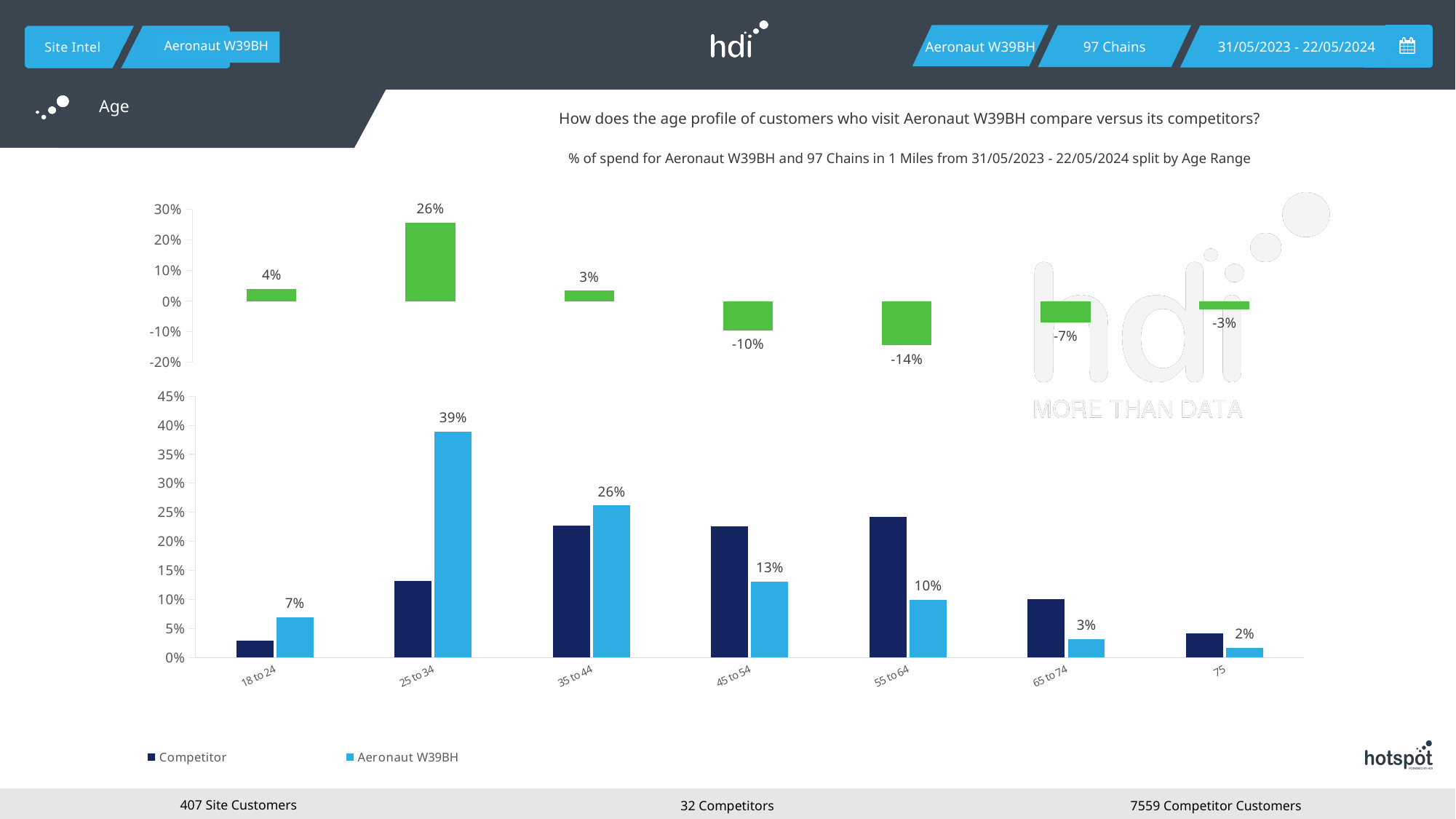
How many series does the legend of the bottom chart list? 2 In the bottom chart, which age range has the lowest Aeronaut W39BH value? 75 In the bottom chart, what is the value for Aeronaut W39BH in the 25 to 34 age range? 39% In the bottom chart, is the Competitor value for 55 to 64 greater or less than 20%? greater In the bottom chart, what is the value for Aeronaut W39BH in the 55 to 64 age range? 10% In the top chart, what is the value for the 55 to 64 age range? -14% In the bottom chart, for the 45 to 54 age range, which series has the larger value: Competitor or Aeronaut W39BH? Competitor In the top chart, which age range has the highest value? 25 to 34 How many age ranges are shown on the x axis of the bottom chart? 7 In the top chart, which age range has the lowest value? 55 to 64 In the bottom chart, what is the difference between the Aeronaut W39BH values for 25 to 34 and 35 to 44? 13% What type of chart is the bottom chart? Bar chart